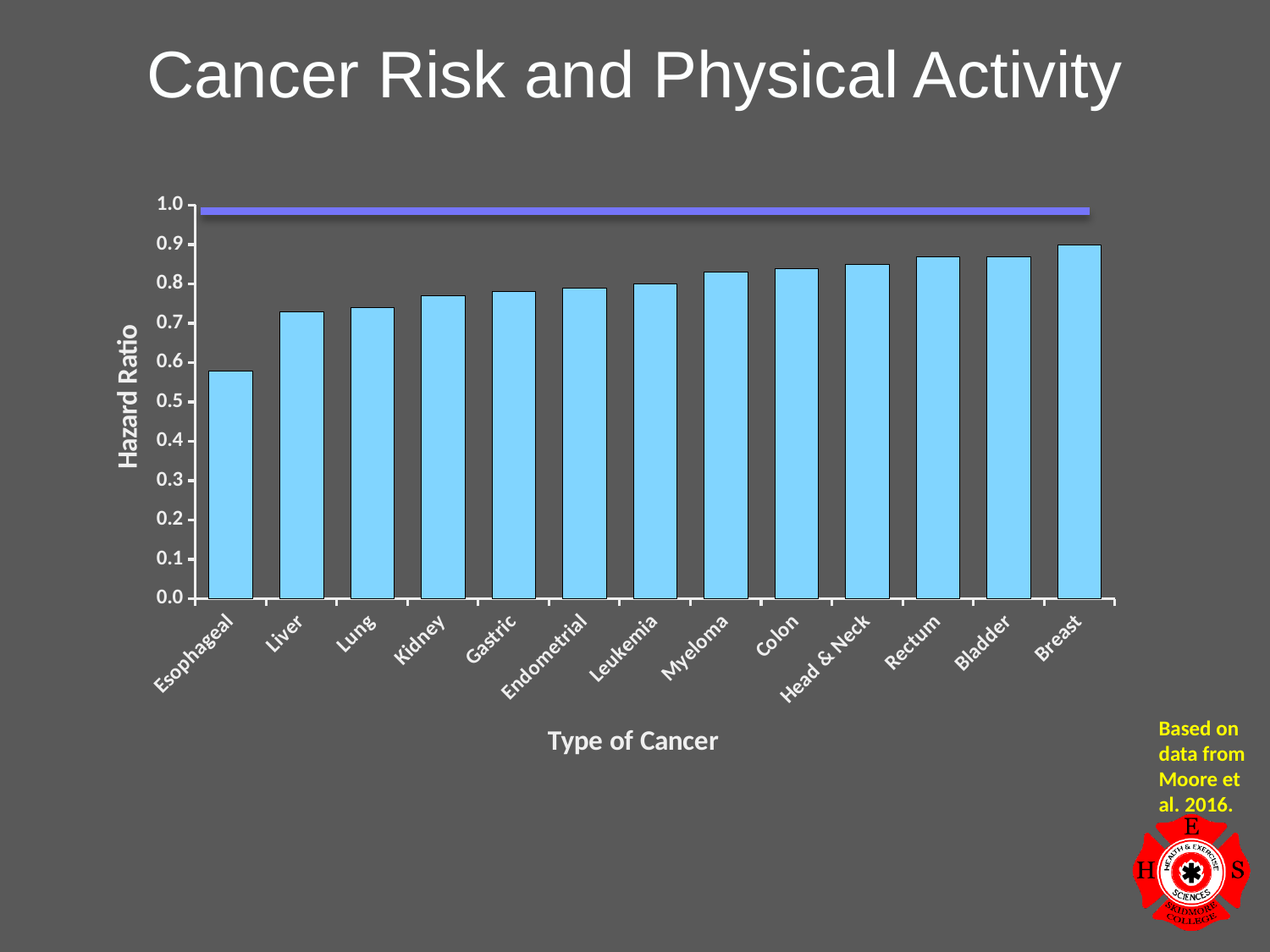
Is the hazard ratio for Esophageal cancer greater or less than 0.7? less Is the hazard ratio for Myeloma greater or less than 0.8? greater What kind of chart is shown on the slide? bar chart Is the hazard ratio for Kidney cancer greater or less than 0.7? greater Which has a higher hazard ratio, Esophageal or Liver cancer? Liver What is the label on the vertical axis of the chart? Hazard Ratio Which type of cancer has the highest hazard ratio? Breast How many types of cancer are plotted on the chart? 13 Do the hazard ratios rise or fall moving from left to right along the x axis? rise Which has a higher hazard ratio, Lung or Breast cancer? Breast Which type of cancer has the lowest hazard ratio? Esophageal